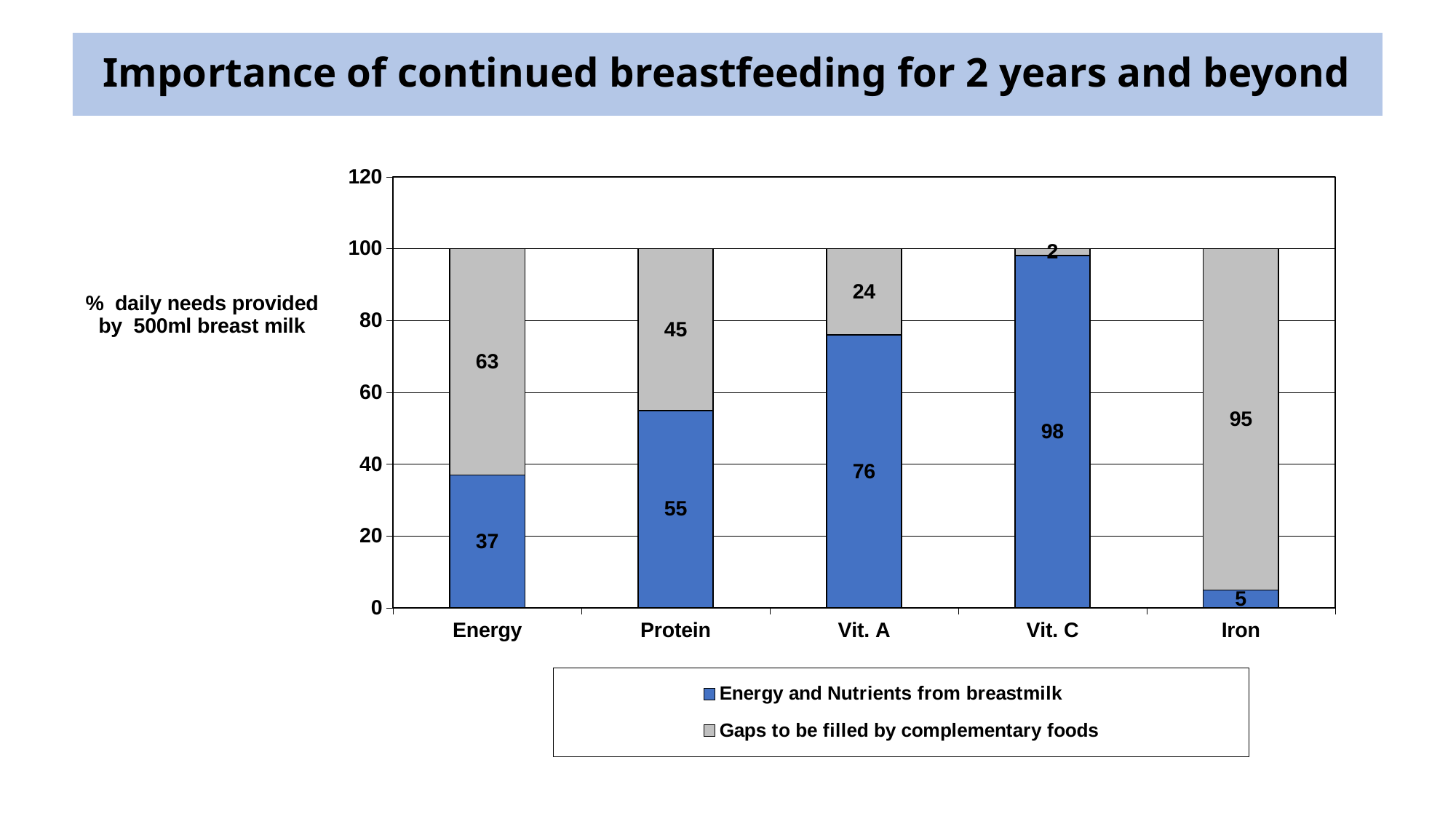
What is the total of the stacked bar for Vit. C? 100 Which is larger: the gap to be filled by complementary foods for Protein or for Vit. A? Protein What is the difference between the breastmilk values for Protein and Energy? 18 What is the value of 'Gaps to be filled by complementary foods' for Iron? 95 What percentage of daily energy needs is provided by 500ml breast milk? 37 How many series does the legend list? 2 What kind of chart is shown on the slide? Stacked bar chart Which nutrient has the lowest value for 'Energy and Nutrients from breastmilk'? Iron What is the value of 'Energy and Nutrients from breastmilk' for Vit. A? 76 Which nutrient has the highest value for 'Energy and Nutrients from breastmilk'? Vit. C How many nutrient categories are shown on the x axis? 5 What is the label of the y axis? % daily needs provided by 500ml breast milk